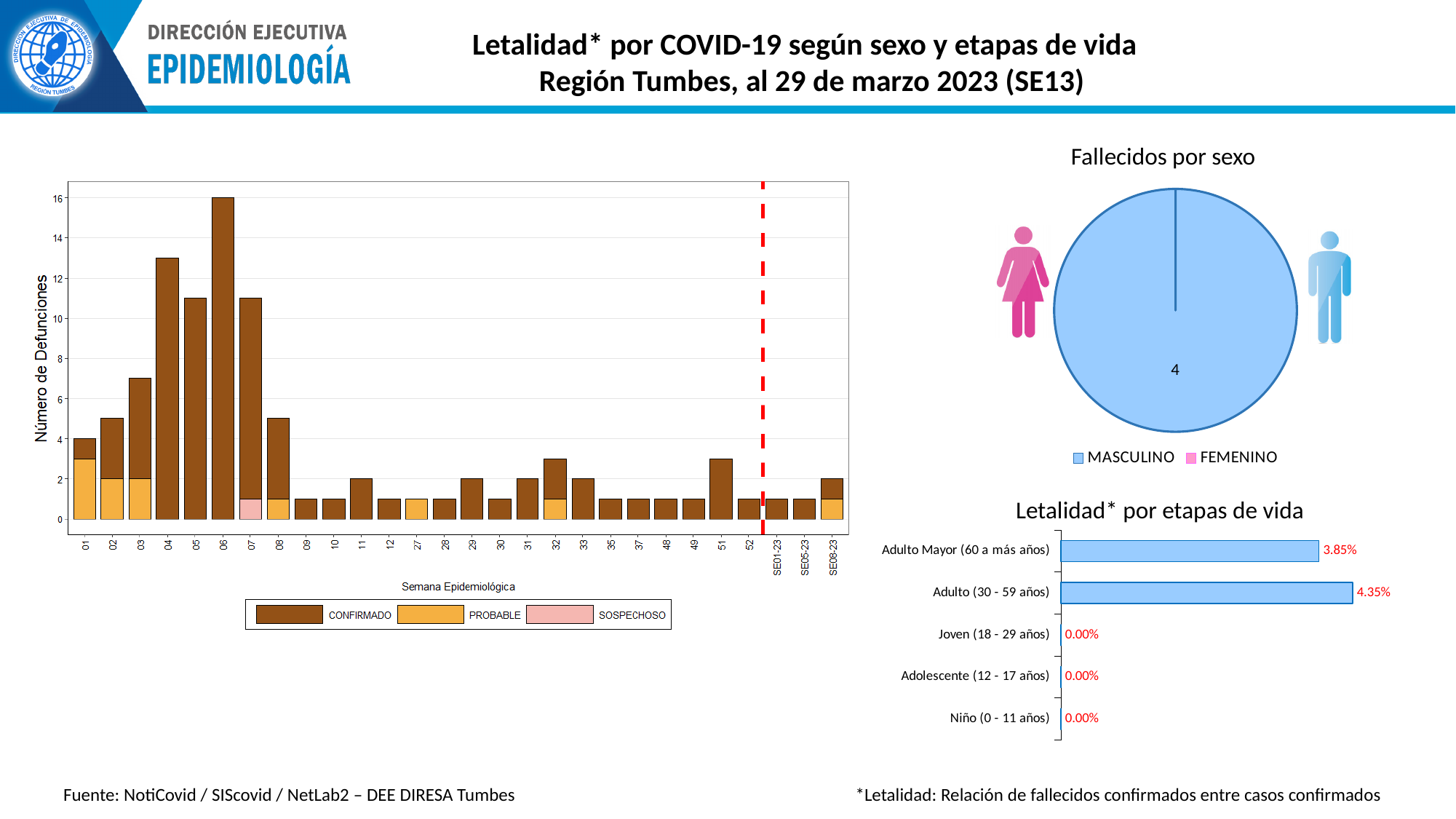
In the bar chart on the left (Número de Defunciones by Semana Epidemiológica), which week has the highest number of deaths? 06 In the 'Letalidad* por etapas de vida' chart, what is the value for Adulto Mayor (60 a más años)? 3.85% How many series does the legend of the 'Fallecidos por sexo' chart list? 2 In the 'Letalidad* por etapas de vida' chart, what is the value for Adulto (30 - 59 años)? 4.35% In the 'Fallecidos por sexo' chart, what value is shown for MASCULINO? 4 In the 'Letalidad* por etapas de vida' chart, what is the difference between the values for Adulto (30 - 59 años) and Adulto Mayor (60 a más años)? 0.50% What kind of chart is 'Fallecidos por sexo'? Pie chart How many series does the legend of the bar chart on the left (Número de Defunciones) list? 3 In the 'Letalidad* por etapas de vida' chart, what is the value for Joven (18 - 29 años)? 0.00% In the 'Letalidad* por etapas de vida' chart, which age group has the highest value? Adulto (30 - 59 años) In the 'Letalidad* por etapas de vida' chart, how many age groups are shown? 5 In the bar chart on the left (Número de Defunciones by Semana Epidemiológica), is the total for week 04 greater or less than 12? greater